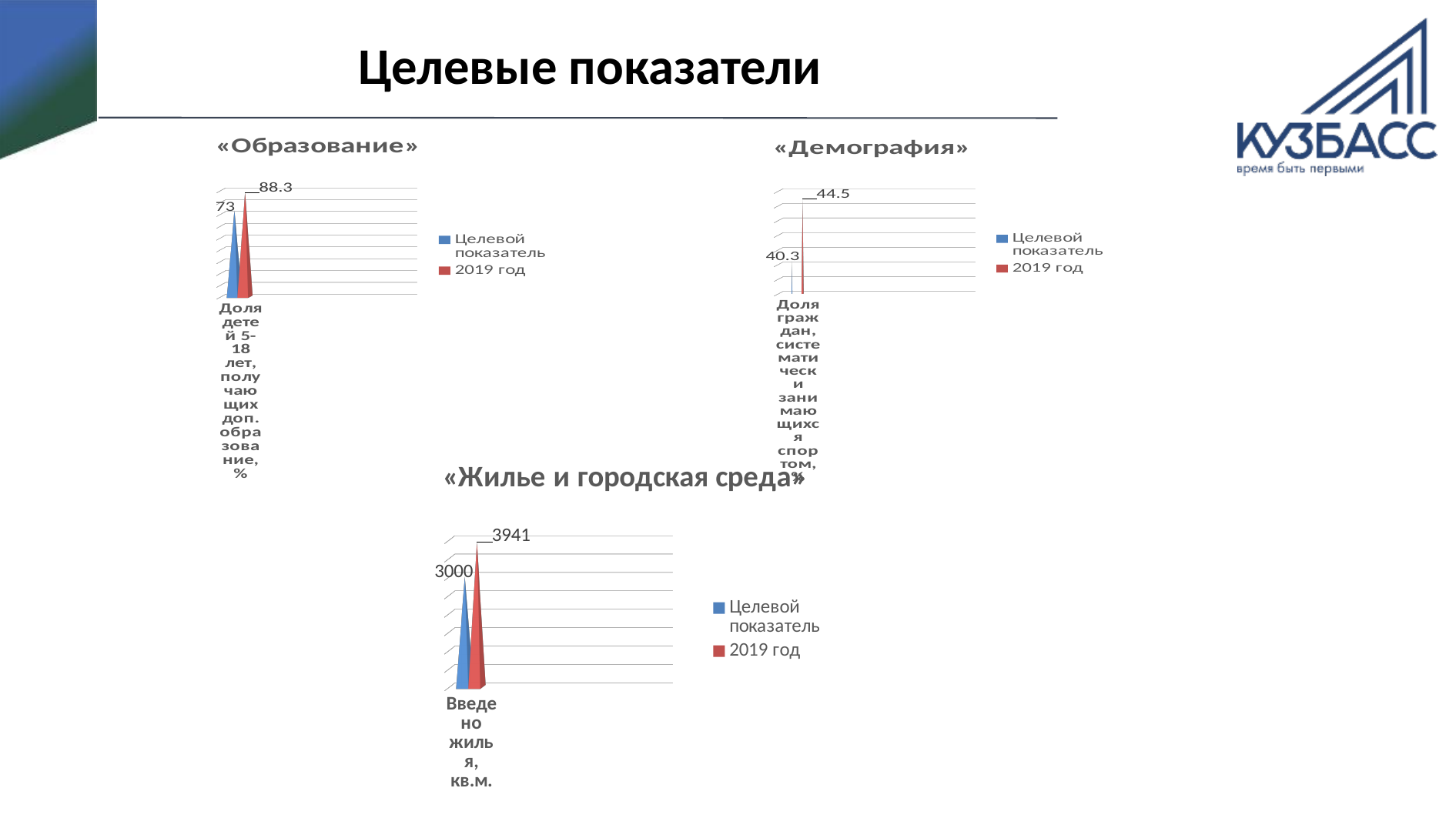
In the «Демография» chart, which colour represents the «2019 год» series? Red In the «Образование» chart, what is the value for «2019 год»? 88.3 In the «Демография» chart, which series has the larger value, «Целевой показатель» or «2019 год»? 2019 год In the «Образование» chart, what is the value for «Целевой показатель»? 73 In the «Жилье и городская среда» chart, what is the difference between the «2019 год» value and the «Целевой показатель» value? 941 In the «Жилье и городская среда» chart, what is the value for «Целевой показатель»? 3000 In the «Демография» chart, what is the value for «Целевой показатель»? 40.3 In the «Демография» chart, what is the value for «2019 год»? 44.5 In the «Жилье и городская среда» chart, what is the value for «2019 год»? 3941 What kind of chart is the «Образование» chart? Bar chart How many series does the legend of the «Жилье и городская среда» chart list? 2 In the «Образование» chart, what is the difference between the «2019 год» value and the «Целевой показатель» value? 15.3